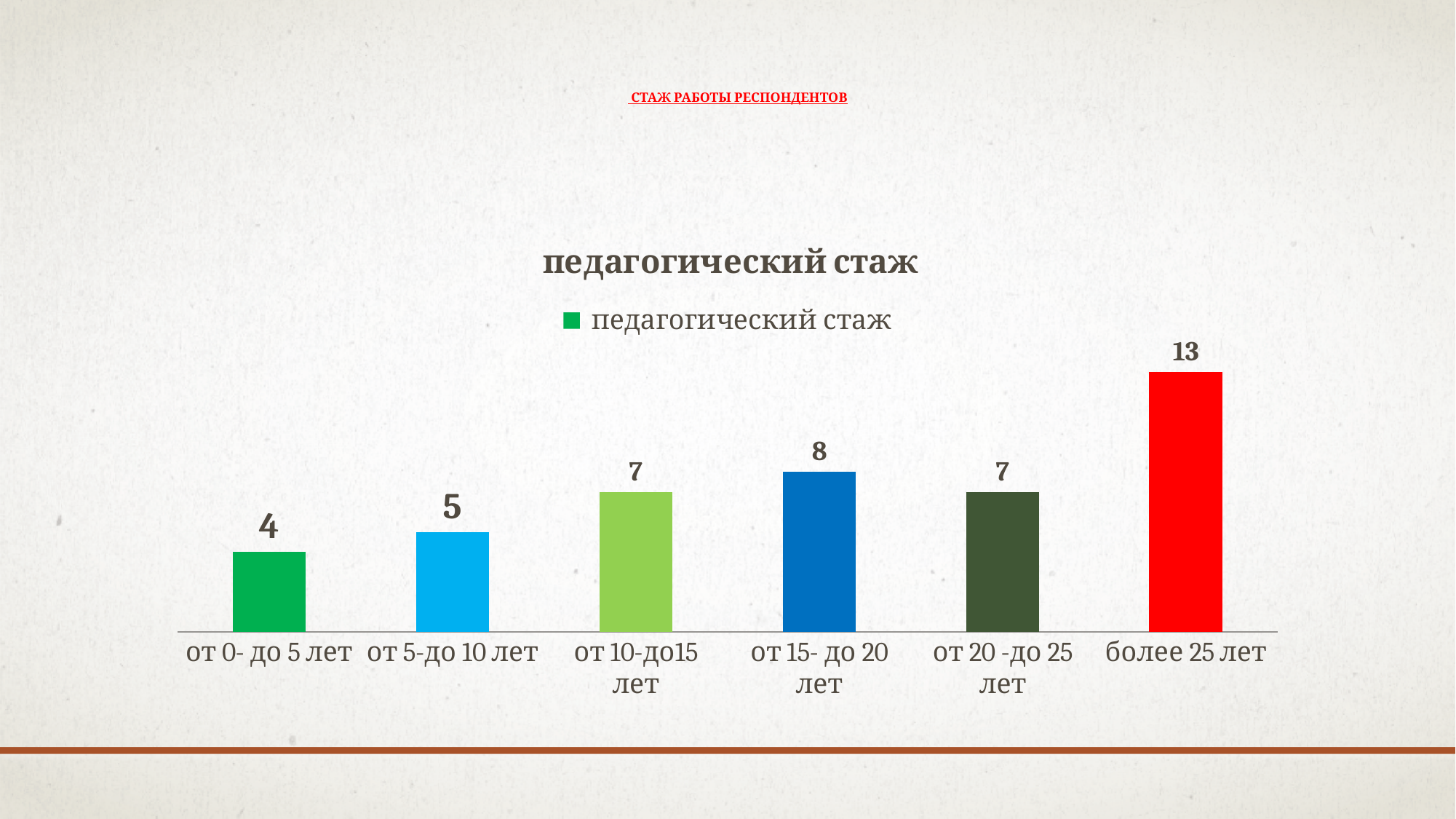
Which category has the highest value? более 25 лет What is the value for the category 'более 25 лет'? 13 How many series does the legend list? 1 How many categories are shown on the x axis? 6 Which is larger: the value for 'от 5-до 10 лет' or the value for 'от 10-до15 лет'? от 10-до15 лет What kind of chart is shown on the slide? bar chart What colour is the bar for 'более 25 лет'? red Which category has the lowest value? от 0- до 5 лет What is the value for the category 'от 0- до 5 лет'? 4 What is the title of the chart? педагогический стаж What is the difference between the values for 'более 25 лет' and 'от 15- до 20 лет'? 5 What is the value for the category 'от 15- до 20 лет'? 8